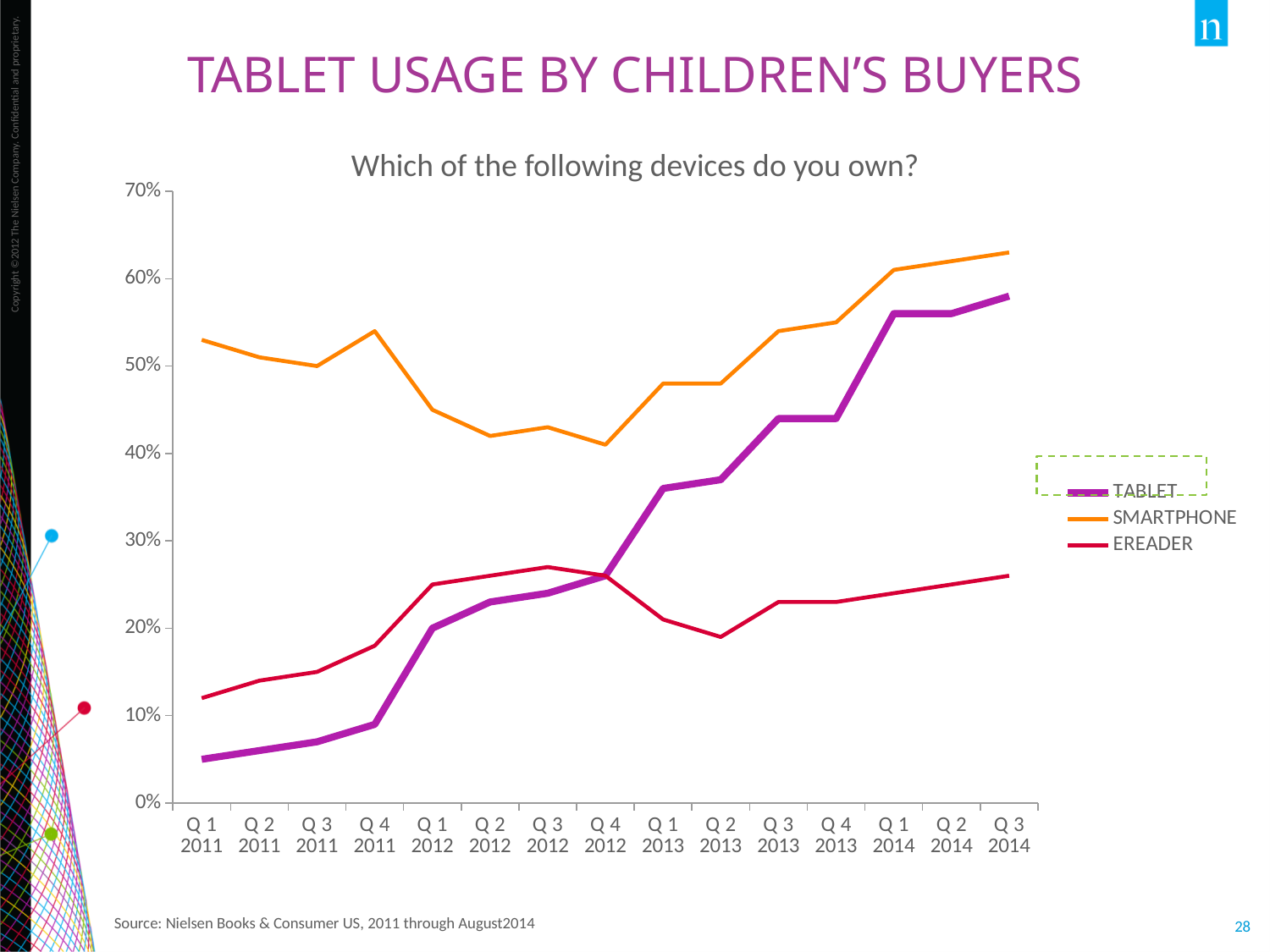
Is the TABLET value for Q1 2014 greater or less than 50%? greater Does the TABLET series generally rise or fall from Q1 2011 to Q3 2014? rise Which series has the highest value in Q3 2014? SMARTPHONE What is the chart's title? Which of the following devices do you own? What kind of chart is shown on the slide? line chart How many series does the legend list? 3 In Q3 2014, which is larger: TABLET or EREADER? TABLET In Q1 2011, which is larger: SMARTPHONE or TABLET? SMARTPHONE How many quarters are plotted along the x axis? 15 Is the TABLET value for Q1 2011 greater or less than 10%? less Is the SMARTPHONE value for Q3 2014 greater or less than 60%? greater